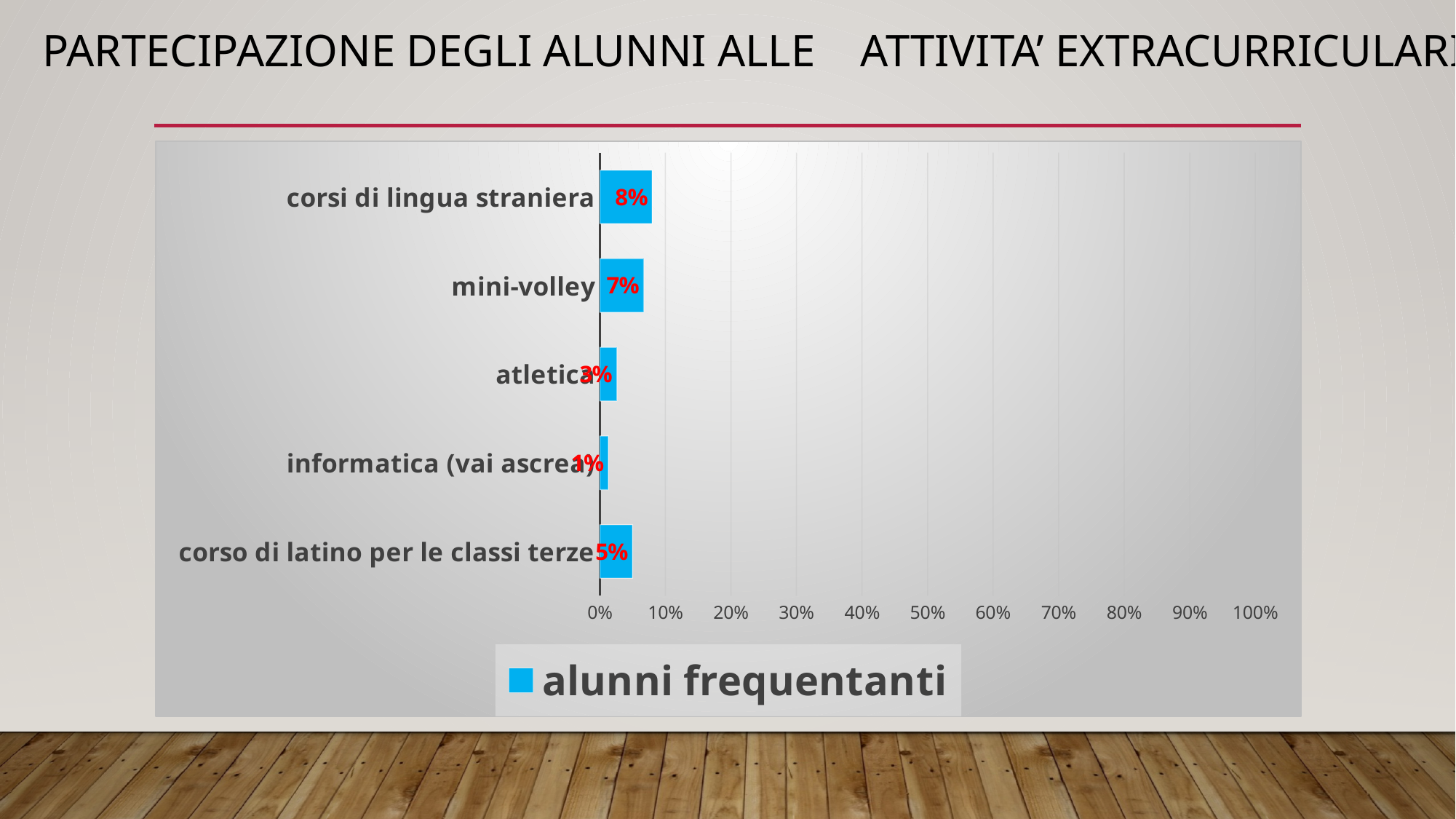
What is the difference between the values for corsi di lingua straniera and mini-volley? 1% What is the value shown for mini-volley? 7% What percentage of students attend corsi di lingua straniera? 8% What is the value shown for corso di latino per le classi terze? 5% What is the value shown for atletica? 3% Which is larger, the value for corso di latino per le classi terze or the value for atletica? corso di latino per le classi terze Is the value for mini-volley greater or less than 10%? less Which activity has the highest participation? corsi di lingua straniera Which activity has the lowest participation? informatica (vai ascrea) How many activities are shown in the chart? 5 What kind of chart is shown on the slide? bar chart What series name does the legend show? alunni frequentanti